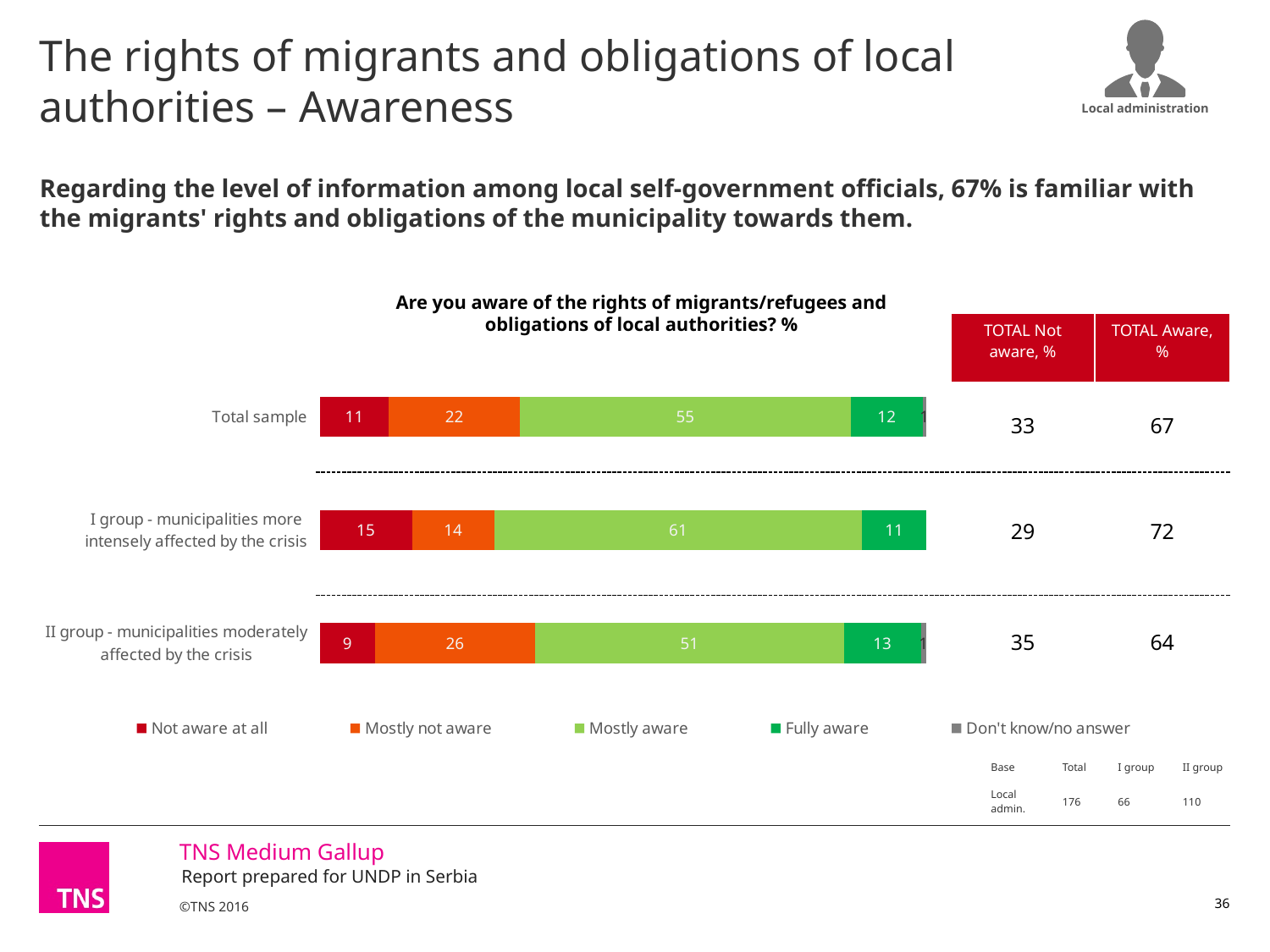
What is the 'Mostly aware' value for the Total sample? 55 How many series does the legend list? 5 What is the TOTAL Aware, % value for I group - municipalities more intensely affected by the crisis? 72 Which category has the highest 'Mostly aware' value? I group - municipalities more intensely affected by the crisis What is the 'Fully aware' value for II group - municipalities moderately affected by the crisis? 13 What is the 'Mostly not aware' value for II group - municipalities moderately affected by the crisis? 26 Which category has the lowest 'Not aware at all' value? II group - municipalities moderately affected by the crisis How many categories are shown on the chart? 3 Is the 'Mostly aware' value larger for the Total sample or for II group - municipalities moderately affected by the crisis? Total sample What is the difference between the 'Mostly not aware' values for II group and I group? 12 What is the 'Not aware at all' value for I group - municipalities more intensely affected by the crisis? 15 What kind of chart is shown on the slide? Stacked bar chart